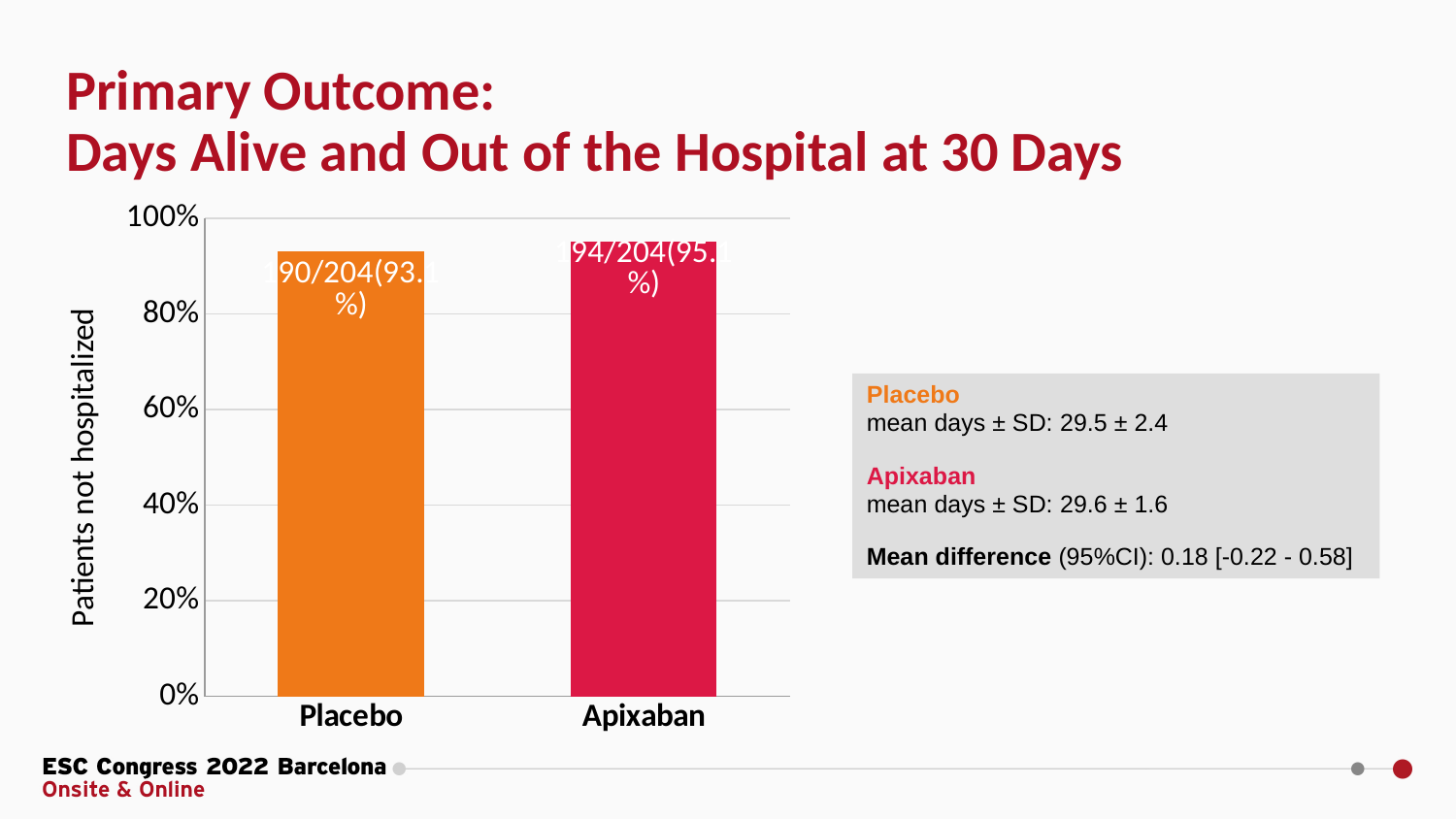
What is the label of the y axis of the chart? Patients not hospitalized What is the mean difference (95% CI) in days alive and out of hospital reported on the slide? 0.18 [-0.22 - 0.58] What are the mean days ± SD for the Placebo group reported on the slide? 29.5 ± 2.4 What is the denominator (total number of patients) shown in the data label for the Placebo bar? 204 How many categories are plotted on the x axis of the chart? 2 What percentage of patients were not hospitalized in the Apixaban group, according to the data label? 95.1% Is the value for Placebo greater or less than 80%? greater Which group has the higher proportion of patients not hospitalized, Placebo or Apixaban? Apixaban What type of chart is shown on the slide? bar chart Is the value for Apixaban greater or less than 100%? less Which bar is the lowest in the chart? Placebo What colour is the Apixaban bar? red